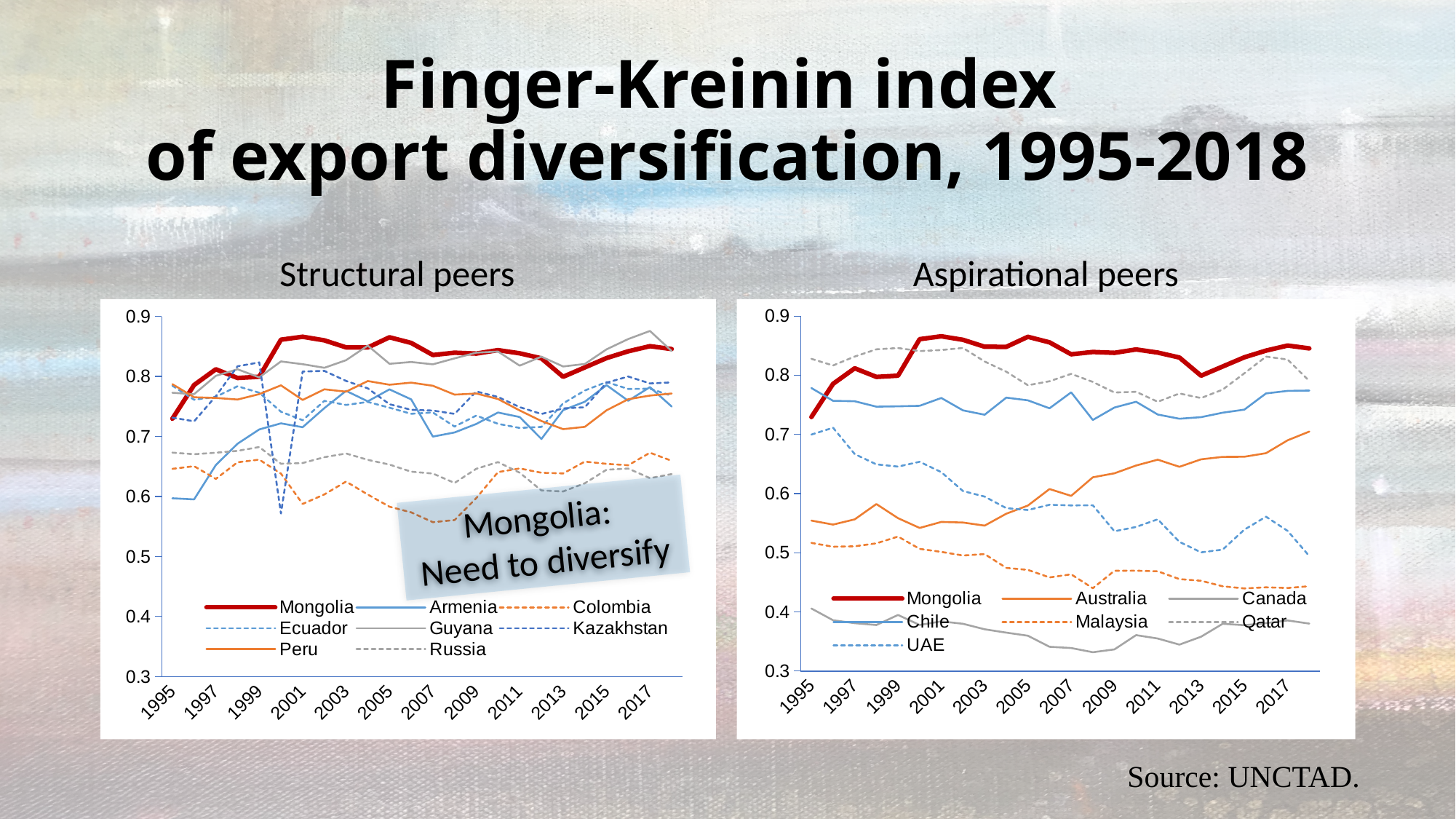
In the Aspirational peers chart, which series has the lowest values across the period? Canada In the Aspirational peers chart, is the value for Mongolia in 2001 greater or less than 0.8? greater In the Aspirational peers chart, which series has the highest value in 2018? Mongolia In the Aspirational peers chart, is the value for Canada in 2009 greater or less than 0.4? less How many series does the legend of the Aspirational peers chart list? 7 In the Aspirational peers chart, which is larger in 2018, Chile or Australia? Chile What is the source cited for the charts on the slide? UNCTAD What kind of chart is the Structural peers chart? line chart In the Aspirational peers chart, is the value for Malaysia in 2017 greater or less than 0.5? less In the Aspirational peers chart, does the value for Australia rise or fall from 1995 to 2018? rise How many series does the legend of the Structural peers chart list? 8